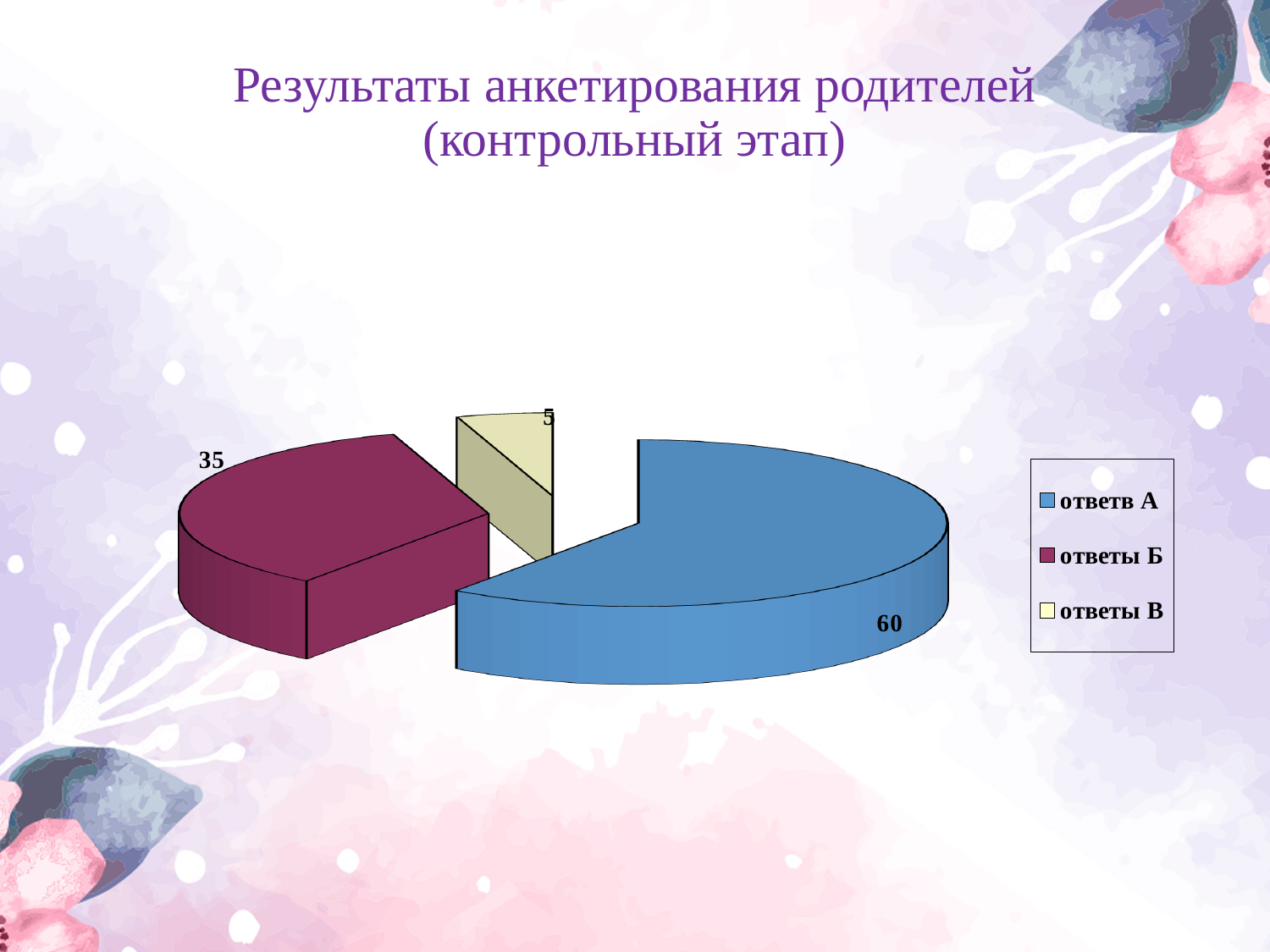
Which category has the smallest slice? ответы В What kind of chart is shown on the slide? pie chart What is the difference between the values for ответы Б and ответы В? 30 What is the value for ответы В? 5 Which category has the largest slice? ответв А What is the difference between the values for ответв А and ответы Б? 25 What is the title of the slide containing the chart? Результаты анкетирования родителей (контрольный этап) What is the value for ответв А? 60 How many slices does the pie chart have? 3 What share of the pie does ответв А represent? 60% What is the value for ответы Б? 35 Which is larger, the value for ответы Б or the value for ответы В? ответы Б